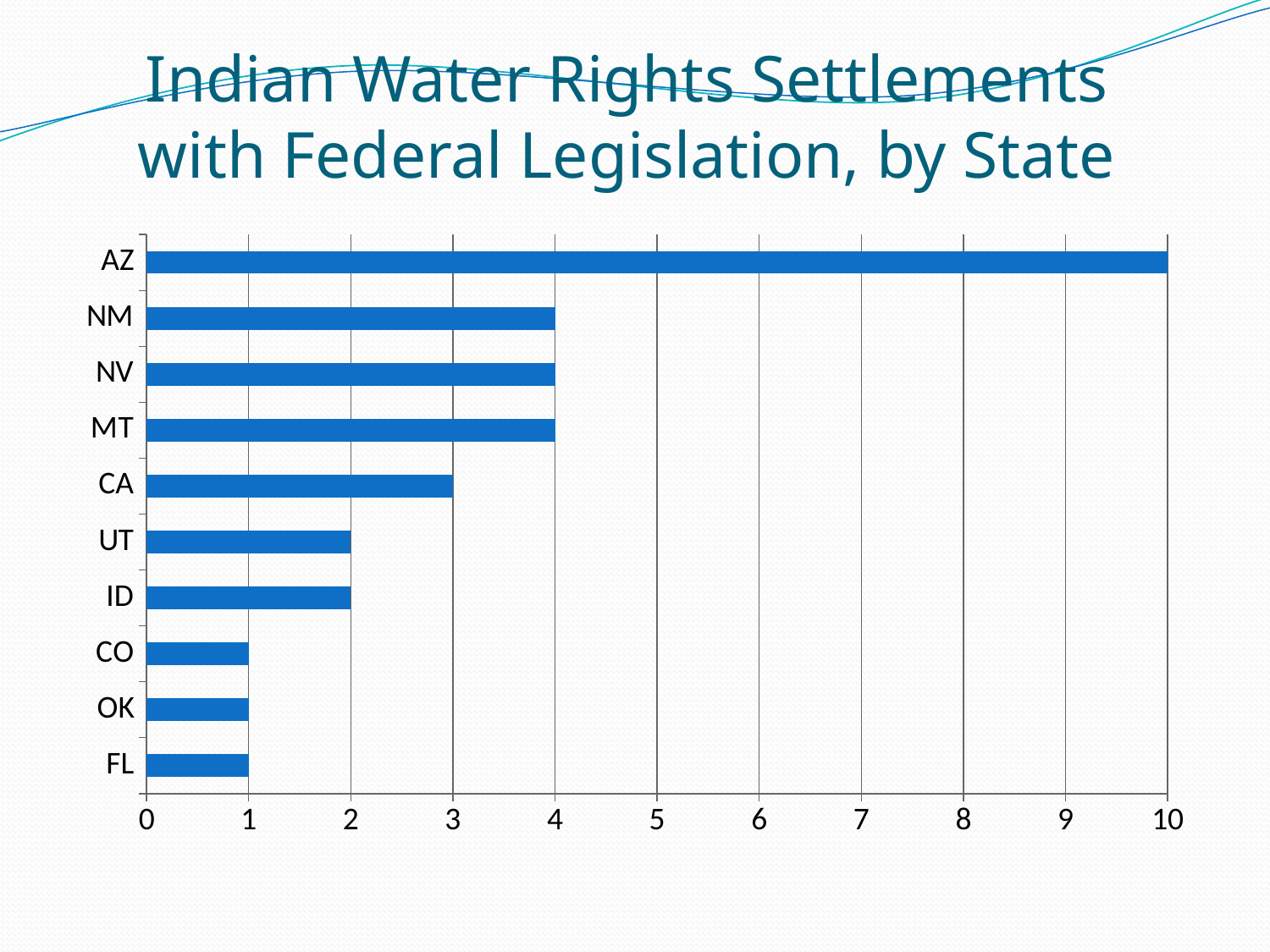
What is the difference between the values for CA and FL? 2 Is the value for AZ greater or less than 5? greater What kind of chart is shown on the slide? bar chart Which is larger, the value for NV or the value for ID? NV What is the value for NM? 4 What is the title of the chart on the slide? Indian Water Rights Settlements with Federal Legislation, by State What is the value for UT? 2 What is the difference between the values for AZ and MT? 6 How many states are shown on the chart? 10 Which state has the highest value? AZ What is the value for CA? 3 What is the value for AZ? 10